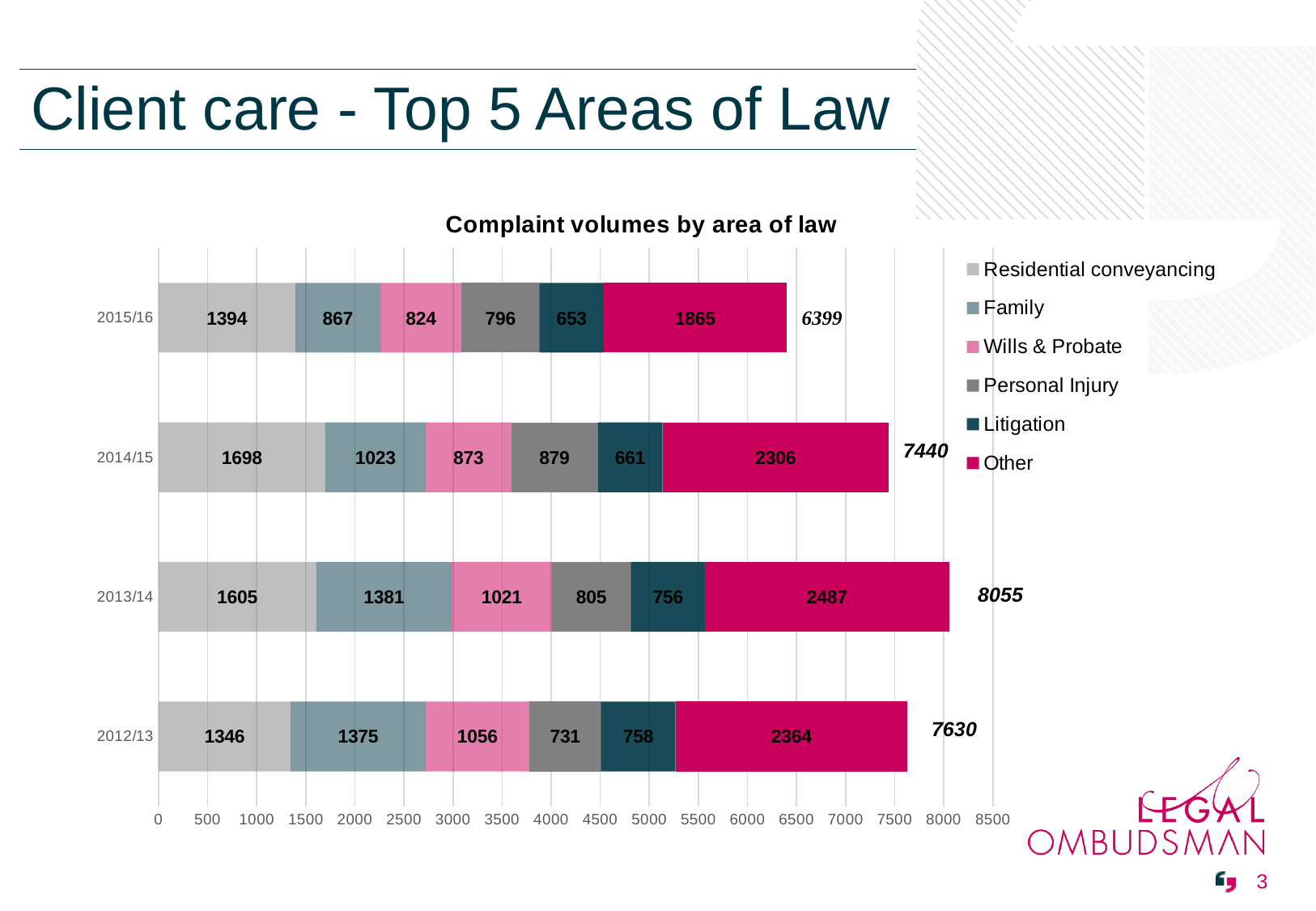
What is the Residential conveyancing value for 2015/16? 1394 What is the Wills & Probate value for 2012/13? 1056 What is the total of the stacked bar for 2014/15? 7440 What is the title of the chart? Complaint volumes by area of law What is the Litigation value for 2014/15? 661 What is the Other value for 2013/14? 2487 Which year has the highest total complaint volume? 2013/14 Which year has the lowest total complaint volume? 2015/16 How many series does the legend list? 6 What is the difference between the Family values for 2013/14 and 2015/16? 514 What kind of chart is shown? Stacked bar chart Which is larger, the Personal Injury value for 2014/15 or for 2012/13? 2014/15